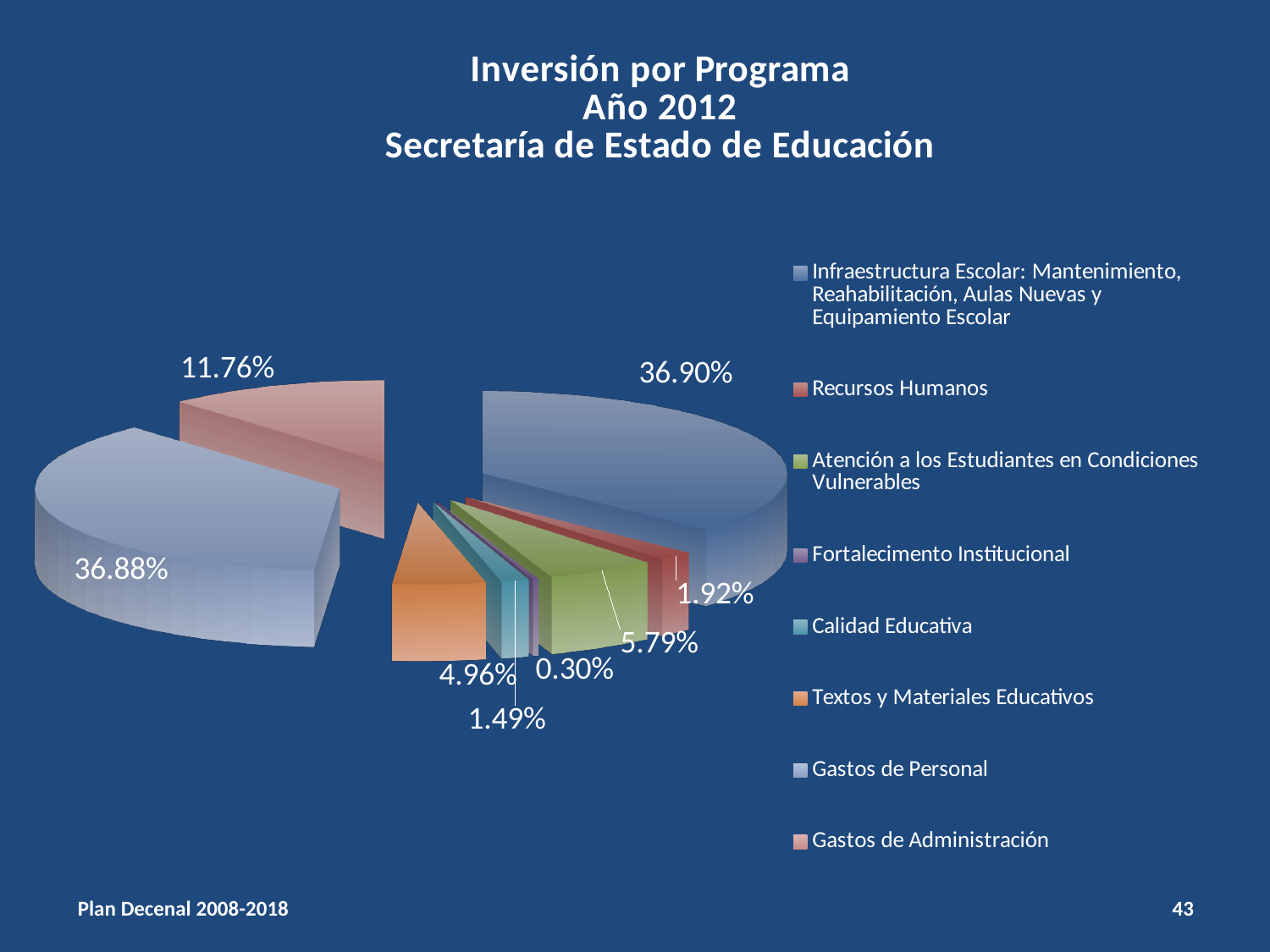
What is the value shown for Atención a los Estudiantes en Condiciones Vulnerables? 5.79% What is the smallest percentage shown on the pie chart? 0.30% Which program has the smallest share of the pie? Fortalecimento Institucional What is the value shown for Recursos Humanos? 1.92% What is the value shown for Calidad Educativa? 1.49% What is the value shown for Textos y Materiales Educativos? 4.96% What is the title of the chart? Inversión por Programa Año 2012 Secretaría de Estado de Educación How many categories does the legend of the pie chart list? 8 What share of the pie does Gastos de Administración represent? 11.76% What kind of chart is shown on the slide? Pie chart Which is larger, the share for Recursos Humanos or the share for Calidad Educativa? Recursos Humanos What is the difference between the shares of Gastos de Administración and Textos y Materiales Educativos? 6.80%